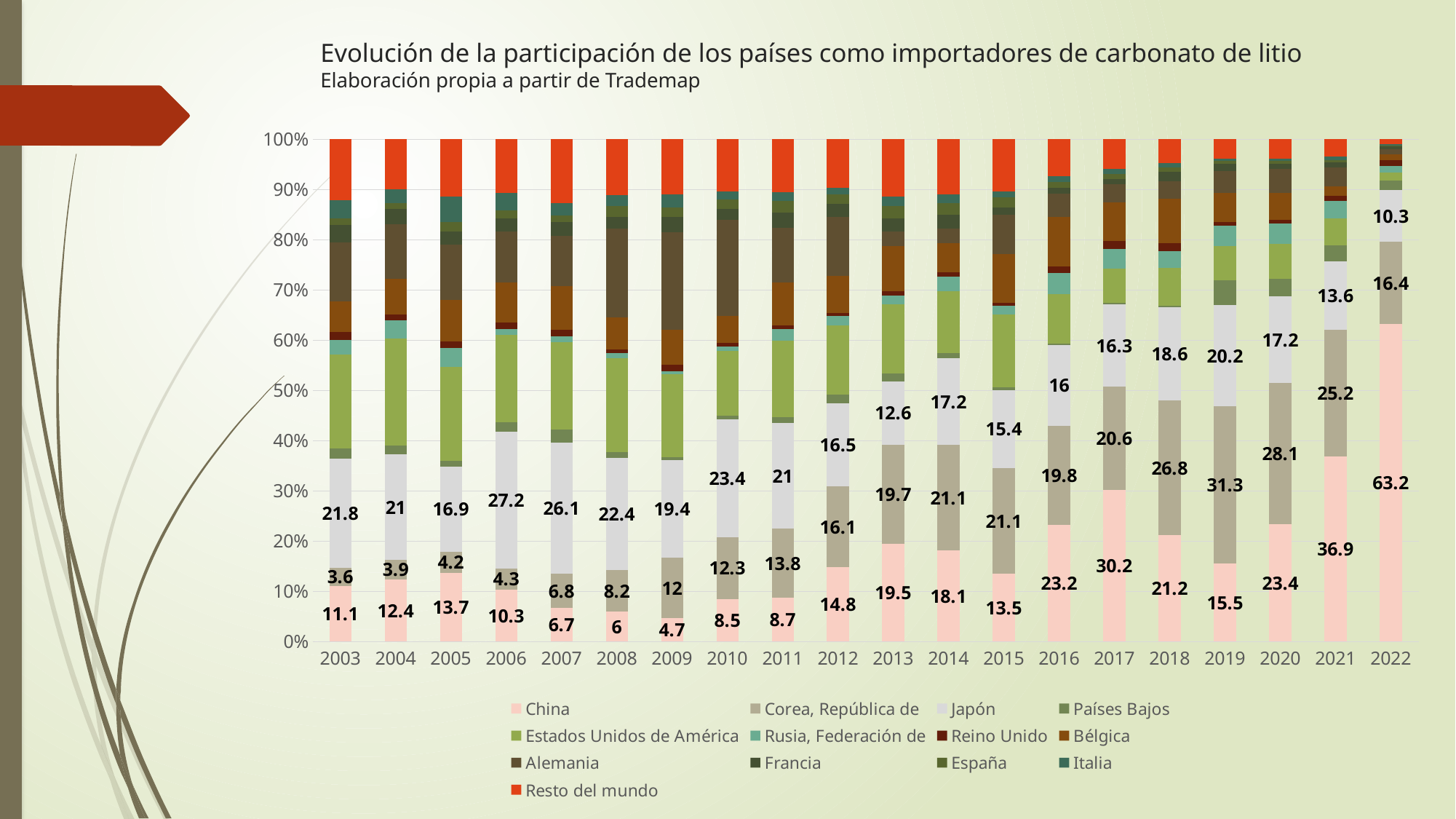
In which year does China have its lowest labelled value? 2009 What type of chart is shown on the slide? stacked bar chart What is the value labelled for Japón in 2006? 27.2 How many series does the legend list? 13 What is the combined labelled share of China, Corea, República de and Japón in 2022? 89.9 How many years are shown on the x axis? 20 What is the value labelled for Corea, República de in 2019? 31.3 In which year does China have its highest labelled value? 2022 What is the difference between the China values in 2022 and 2021? 26.3 Do the labelled values for China rise or fall from 2019 to 2022? rise What is the value labelled for China in 2022? 63.2 Which is larger in 2018, the value for China or the value for Corea, República de? Corea, República de